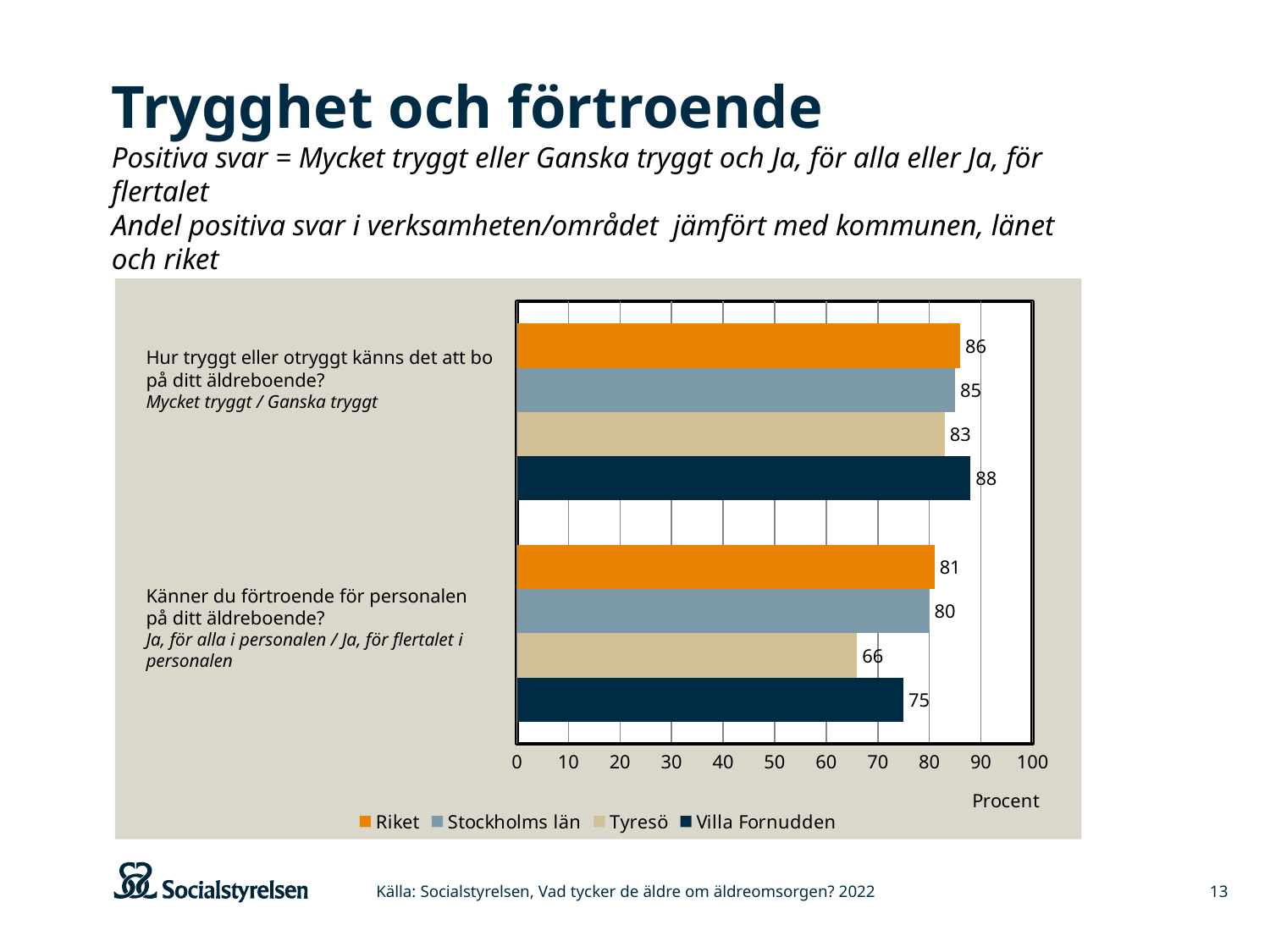
What is the difference between Riket and Tyresö on the question "Känner du förtroende för personalen på ditt äldreboende?"? 15 Which series has the lowest value on the question "Känner du förtroende för personalen på ditt äldreboende?"? Tyresö What is the label of the x axis? Procent Which is larger on the question "Känner du förtroende för personalen på ditt äldreboende?": Villa Fornudden or Tyresö? Villa Fornudden What is the difference between Villa Fornudden and Tyresö on the question "Hur tryggt eller otryggt känns det att bo på ditt äldreboende?"? 5 What is the value for Tyresö on the question "Känner du förtroende för personalen på ditt äldreboende?"? 66 What is the value for Riket on the question "Känner du förtroende för personalen på ditt äldreboende?"? 81 What kind of chart is shown on the slide? Bar chart What is the value for Stockholms län on the question "Hur tryggt eller otryggt känns det att bo på ditt äldreboende?"? 85 What is the value for Villa Fornudden on the question "Hur tryggt eller otryggt känns det att bo på ditt äldreboende?"? 88 Which series has the highest value on the question "Hur tryggt eller otryggt känns det att bo på ditt äldreboende?"? Villa Fornudden How many series does the legend list? 4